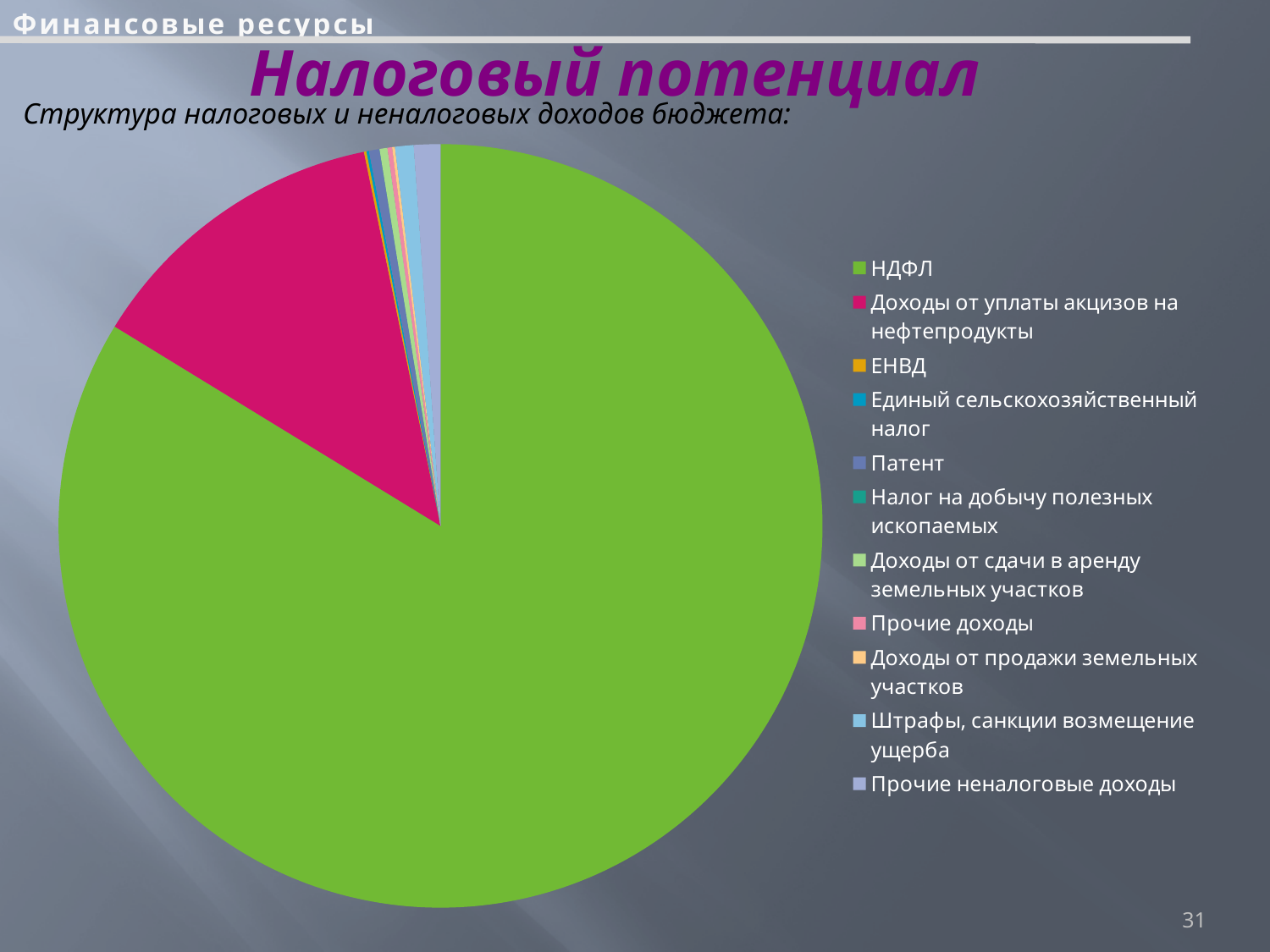
What colour is the НДФЛ slice in the pie chart? green What is the subtitle describing the pie chart on the slide? Структура налоговых и неналоговых доходов бюджета: Which category has the second-largest slice of the pie chart? Доходы от уплаты акцизов на нефтепродукты What kind of chart is shown on the slide? pie chart Which category has the largest slice of the pie chart? НДФЛ Which slice is larger: НДФЛ or Доходы от уплаты акцизов на нефтепродукты? НДФЛ How many categories does the legend of the pie chart list? 11 Does the НДФЛ slice take up more or less than half of the pie? more Which slice is larger: Доходы от уплаты акцизов на нефтепродукты or ЕНВД? Доходы от уплаты акцизов на нефтепродукты